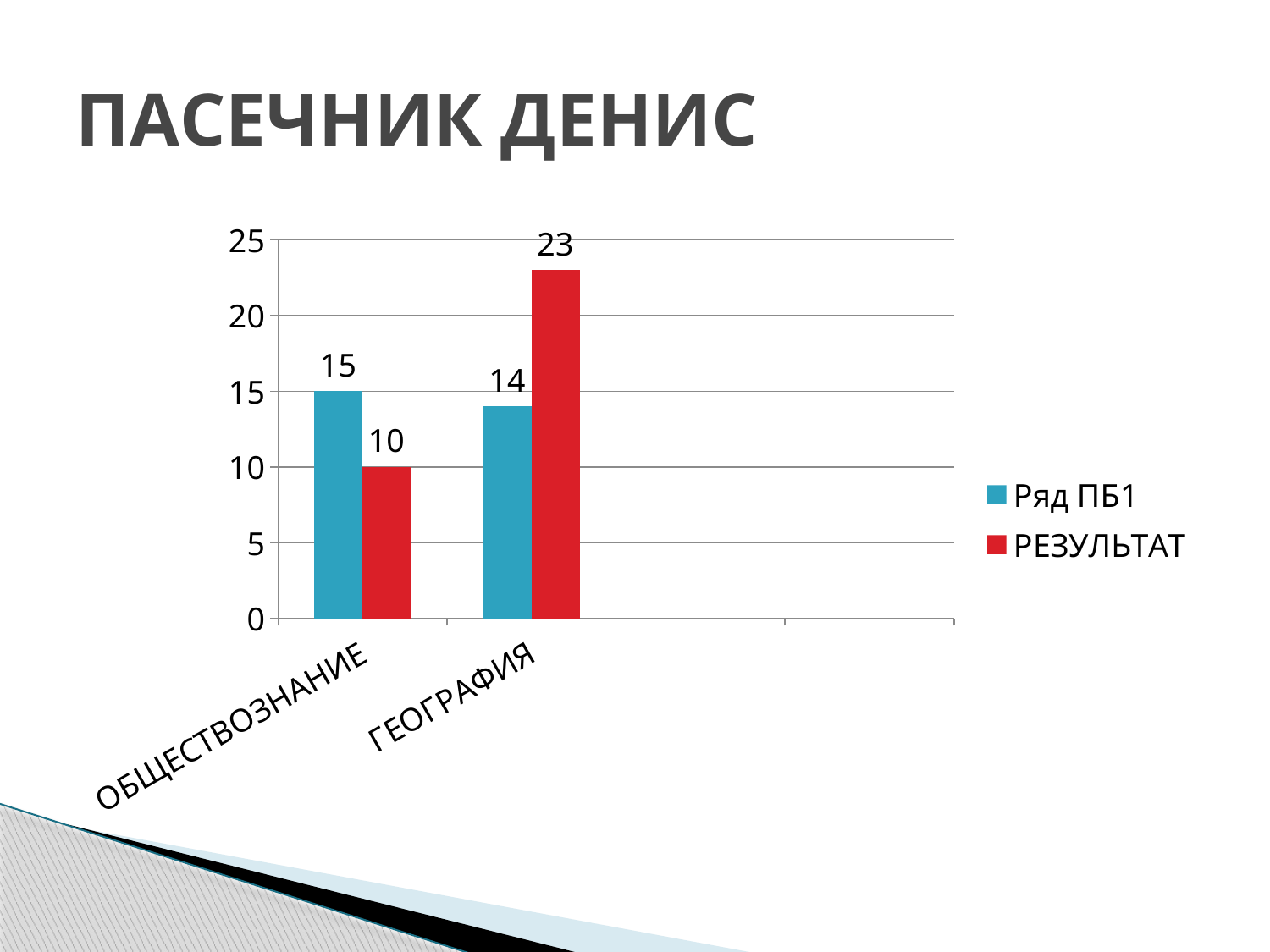
How many categories are shown on the x axis? 2 What is the value of Ряд ПБ1 for ГЕОГРАФИЯ? 14 What is the value of РЕЗУЛЬТАТ for ГЕОГРАФИЯ? 23 What is the difference between the РЕЗУЛЬТАТ values for ГЕОГРАФИЯ and ОБЩЕСТВОЗНАНИЕ? 13 Which category has the lowest РЕЗУЛЬТАТ value? ОБЩЕСТВОЗНАНИЕ What is the value of РЕЗУЛЬТАТ for ОБЩЕСТВОЗНАНИЕ? 10 For ГЕОГРАФИЯ, what is the difference between РЕЗУЛЬТАТ and Ряд ПБ1? 9 What is the value of Ряд ПБ1 for ОБЩЕСТВОЗНАНИЕ? 15 Which category has the highest РЕЗУЛЬТАТ value? ГЕОГРАФИЯ How many series does the legend list? 2 For ОБЩЕСТВОЗНАНИЕ, which is larger: Ряд ПБ1 or РЕЗУЛЬТАТ? Ряд ПБ1 What kind of chart is shown on the slide? Bar chart